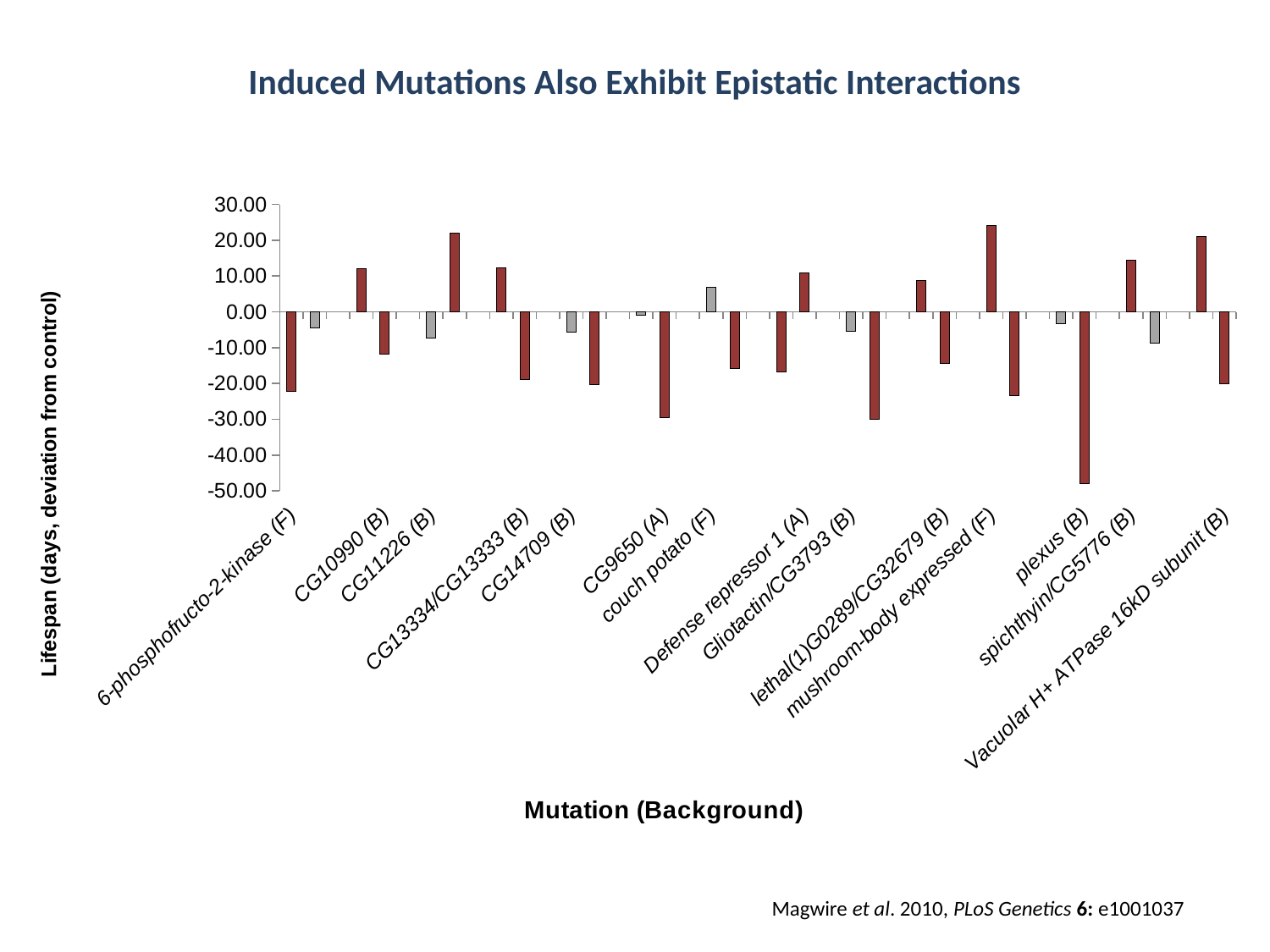
Is the first bar for 6-phosphofructo-2-kinase (F) greater or less than -10? less Which is lower, the lowest bar for plexus (B) or the lowest bar for Gliotactin/CG3793 (B)? plexus (B) Is the lowest bar for plexus (B) greater or less than -40? less What is the title of the chart? Induced Mutations Also Exhibit Epistatic Interactions Is the lowest bar for CG9650 (A) greater or less than -20? less What is the label of the vertical axis? Lifespan (days, deviation from control) How many mutation categories are shown along the x axis? 14 Which mutation has the lowest (most negative) bar on the chart? plexus (B) What kind of chart is shown on the slide? bar chart How many bars are plotted for each mutation category? 2